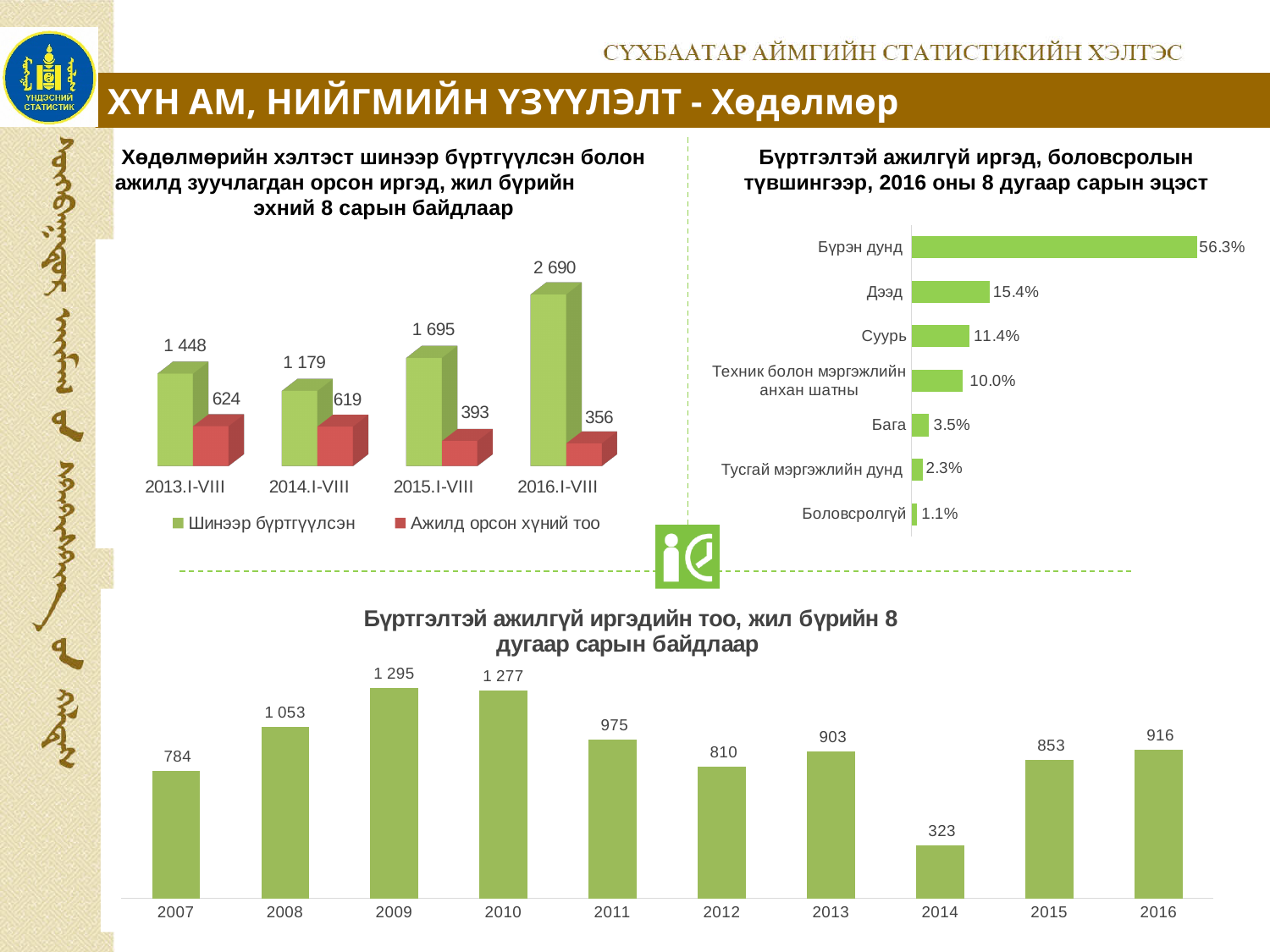
In the top-left chart (Хөдөлмөрийн хэлтэст шинээр бүртгүүлсэн болон ажилд зуучлагдан орсон иргэд), what is the difference between Шинээр бүртгүүлсэн and Ажилд орсон хүний тоо for 2013.I-VIII? 824 In the bottom chart (Бүртгэлтэй ажилгүй иргэдийн тоо), which year has the highest value? 2009 In the bottom chart (Бүртгэлтэй ажилгүй иргэдийн тоо), what is the value for 2014? 323 In the top-right chart (Бүртгэлтэй ажилгүй иргэд, боловсролын түвшингээр), what is the share for Суурь? 11.4% How many series does the legend of the top-left chart (Хөдөлмөрийн хэлтэст шинээр бүртгүүлсэн болон ажилд зуучлагдан орсон иргэд) list? 2 In the top-right chart (Бүртгэлтэй ажилгүй иргэд, боловсролын түвшингээр), which education level has the lowest share? Боловсролгүй In the top-left chart (Хөдөлмөрийн хэлтэст шинээр бүртгүүлсэн болон ажилд зуучлагдан орсон иргэд), what is the value of Ажилд орсон хүний тоо for 2014.I-VIII? 619 In the top-right chart (Бүртгэлтэй ажилгүй иргэд, боловсролын түвшингээр), which education level has the highest share? Бүрэн дунд In the top-left chart (Хөдөлмөрийн хэлтэст шинээр бүртгүүлсэн болон ажилд зуучлагдан орсон иргэд), does the Ажилд орсон хүний тоо series rise or fall from 2013.I-VIII to 2016.I-VIII? fall How many categories are shown in the top-right chart (Бүртгэлтэй ажилгүй иргэд, боловсролын түвшингээр)? 7 In the bottom chart (Бүртгэлтэй ажилгүй иргэдийн тоо), which is larger, the value for 2011 or the value for 2013? 2011 In the top-left chart (Хөдөлмөрийн хэлтэст шинээр бүртгүүлсэн болон ажилд зуучлагдан орсон иргэд), what is the value of Шинээр бүртгүүлсэн for 2016.I-VIII? 2 690